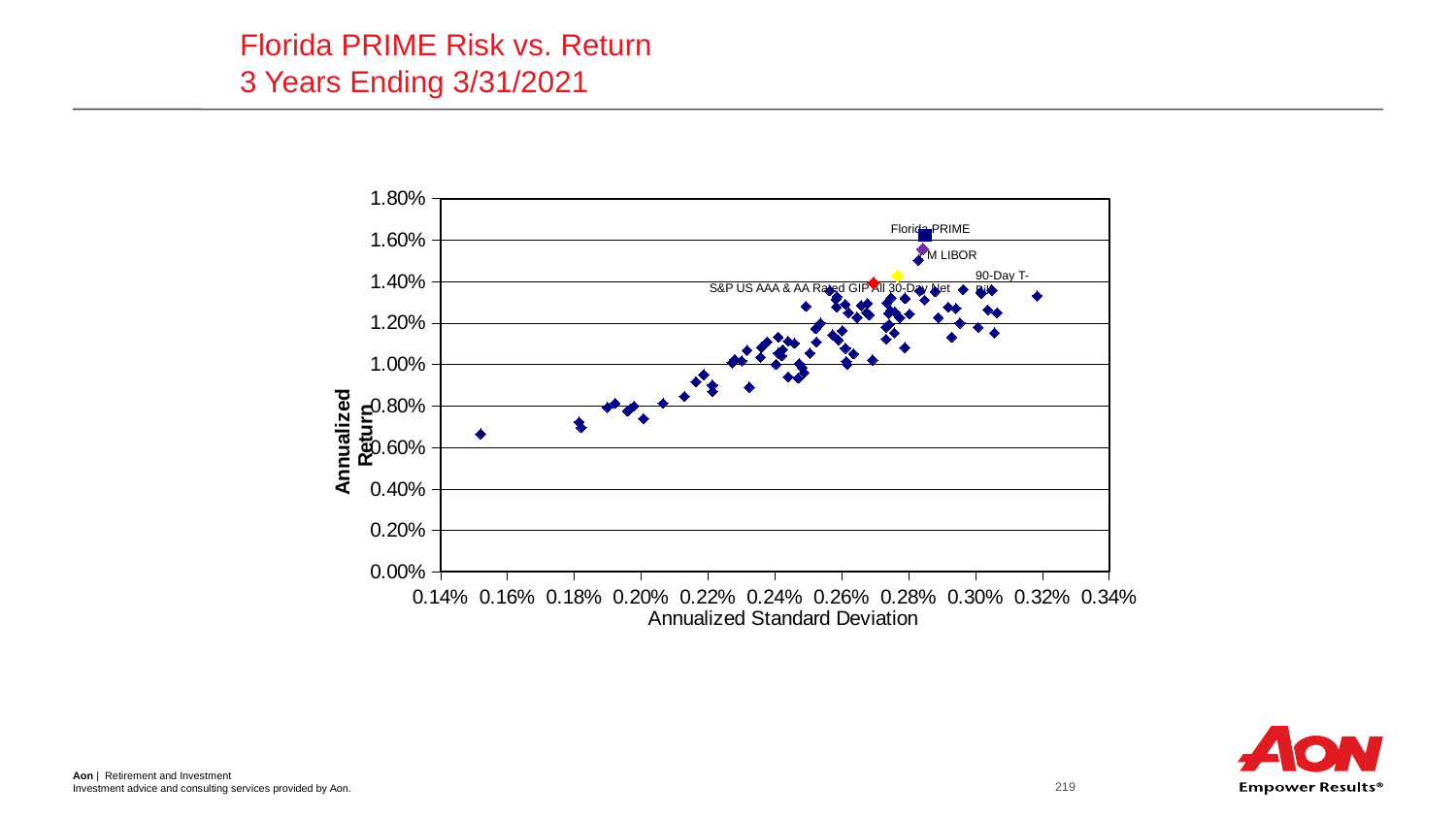
Do annualized returns generally rise or fall as annualized standard deviation increases along the x axis? rise Is the annualized return for 1M LIBOR greater or less than 1.40%? greater Is the annualized standard deviation for Florida PRIME greater or less than 0.26%? greater Is the annualized return for S&P US AAA & AA Rated GIP All 30-Day Net greater or less than 1.60%? less What is the label of the horizontal axis of the chart? Annualized Standard Deviation Which has the higher annualized return, Florida PRIME or S&P US AAA & AA Rated GIP All 30-Day Net? Florida PRIME Which has the higher annualized return, Florida PRIME or 1M LIBOR? Florida PRIME Among the labeled points, which has the highest annualized return? Florida PRIME What is the title of the chart on the slide? Florida PRIME Risk vs. Return 3 Years Ending 3/31/2021 What kind of chart is shown on the slide? Scatter chart